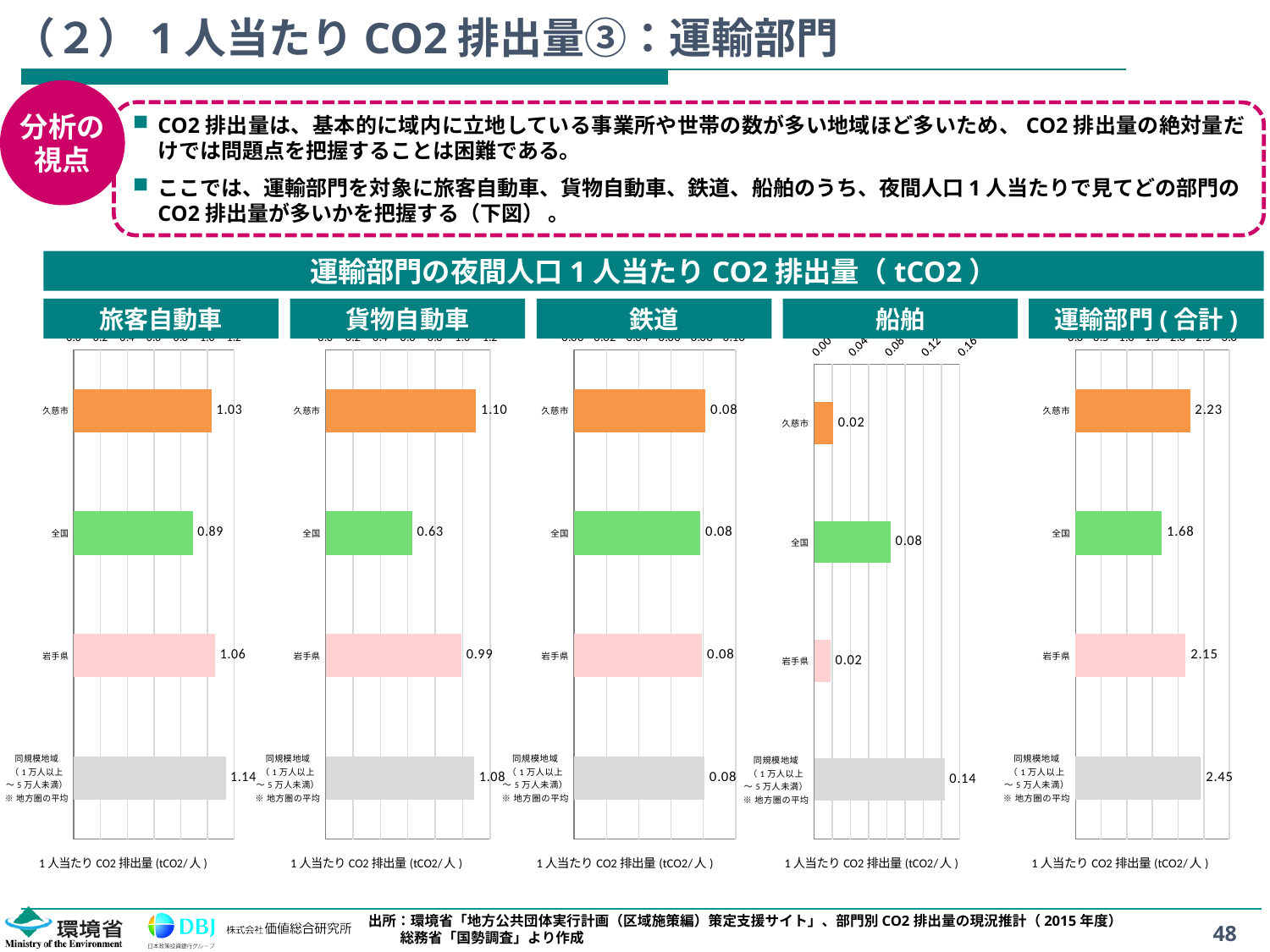
How many categories are shown in the 鉄道 chart? 4 What is the title shown above the five charts? 運輸部門の夜間人口1人当たりCO2排出量（tCO2） In the 旅客自動車 chart, what is the value for 久慈市? 1.03 In the 貨物自動車 chart, what is the value for 全国? 0.63 In the 貨物自動車 chart, which category has the lowest value? 全国 In the 旅客自動車 chart, which is larger, 岩手県 or 全国? 岩手県 In the 船舶 chart, what is the value for 同規模地域? 0.14 What kind of chart is the 運輸部門(合計) chart? bar chart In the 運輸部門(合計) chart, which category has the highest value? 同規模地域 In the 運輸部門(合計) chart, what is the difference between 久慈市 and 全国? 0.55 In the 船舶 chart, is the value for 全国 greater or less than 0.04? greater In the 鉄道 chart, what is the value for 岩手県? 0.08